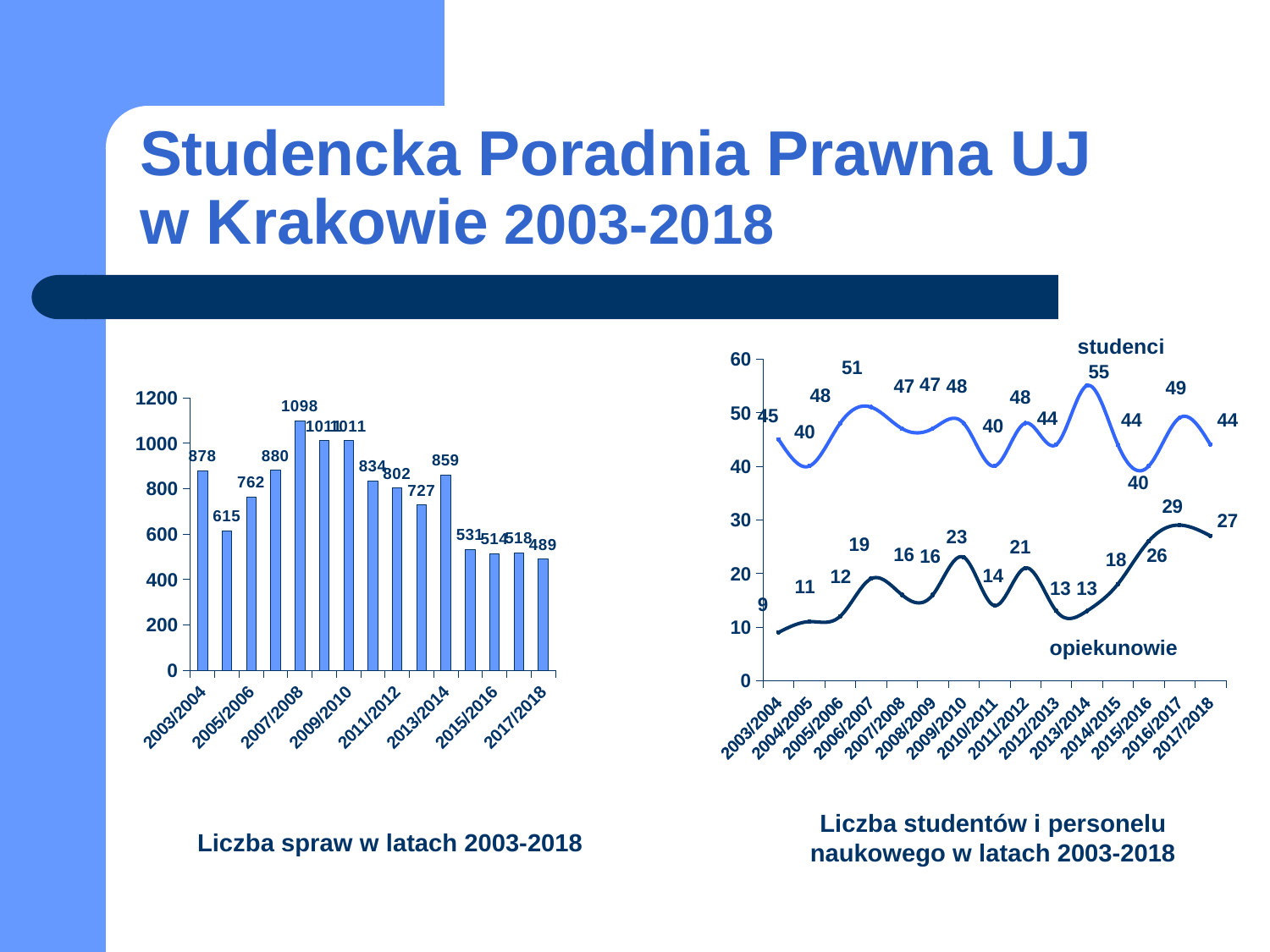
What type of chart is 'Liczba spraw w latach 2003-2018'? bar chart In the chart 'Liczba spraw w latach 2003-2018', which year has the lowest value? 2017/2018 In the chart 'Liczba spraw w latach 2003-2018', what is the difference between the values for 2003/2004 and 2005/2006? 116 How many series are plotted in the chart 'Liczba studentów i personelu naukowego w latach 2003-2018'? 2 In the chart 'Liczba spraw w latach 2003-2018', which is larger, the value for 2013/2014 or the value for 2011/2012? 2013/2014 In the chart 'Liczba studentów i personelu naukowego w latach 2003-2018', in which year does opiekunowie reach its highest value? 2016/2017 In the chart 'Liczba studentów i personelu naukowego w latach 2003-2018', what is the value for opiekunowie in 2003/2004? 9 In the chart 'Liczba spraw w latach 2003-2018', what is the value for 2017/2018? 489 In the chart 'Liczba spraw w latach 2003-2018', what is the value for 2007/2008? 1098 In the chart 'Liczba studentów i personelu naukowego w latach 2003-2018', what is the value for studenci in 2013/2014? 55 In the chart 'Liczba studentów i personelu naukowego w latach 2003-2018', what is the difference between studenci and opiekunowie in 2017/2018? 17 In the chart 'Liczba spraw w latach 2003-2018', which year has the highest value? 2007/2008